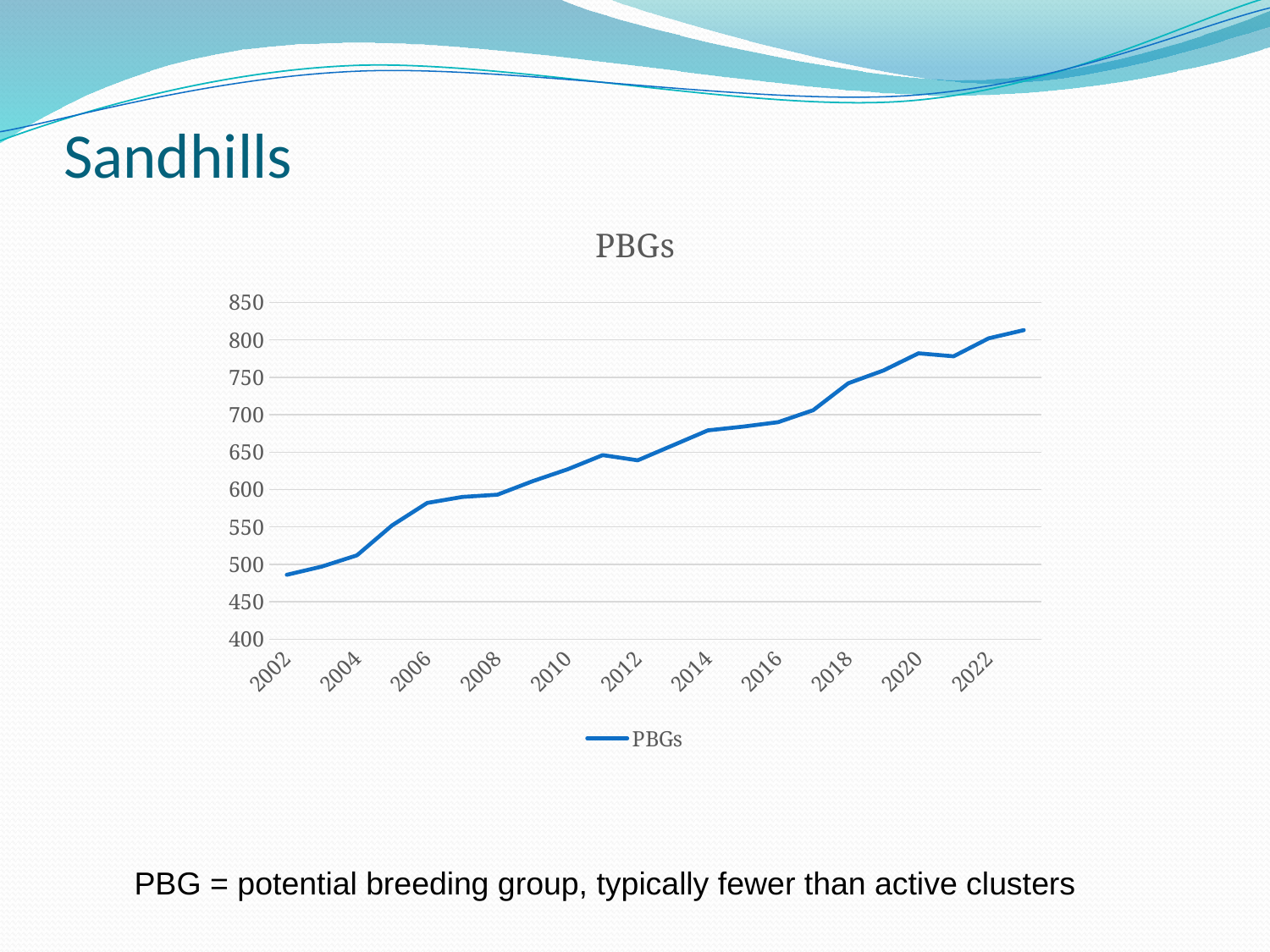
Is the value for 2012 greater or less than 600? greater Is the value for 2016 greater or less than 700? less Is the value for 2002 greater or less than 500? less Which labeled year has the lowest PBGs value? 2002 How many series does the legend list? 1 What is the title of the chart? PBGs Which is larger, the value for 2002 or the value for 2022? 2022 Do the PBGs values generally rise or fall from 2002 to 2022? rise What kind of chart is shown on the slide? line chart